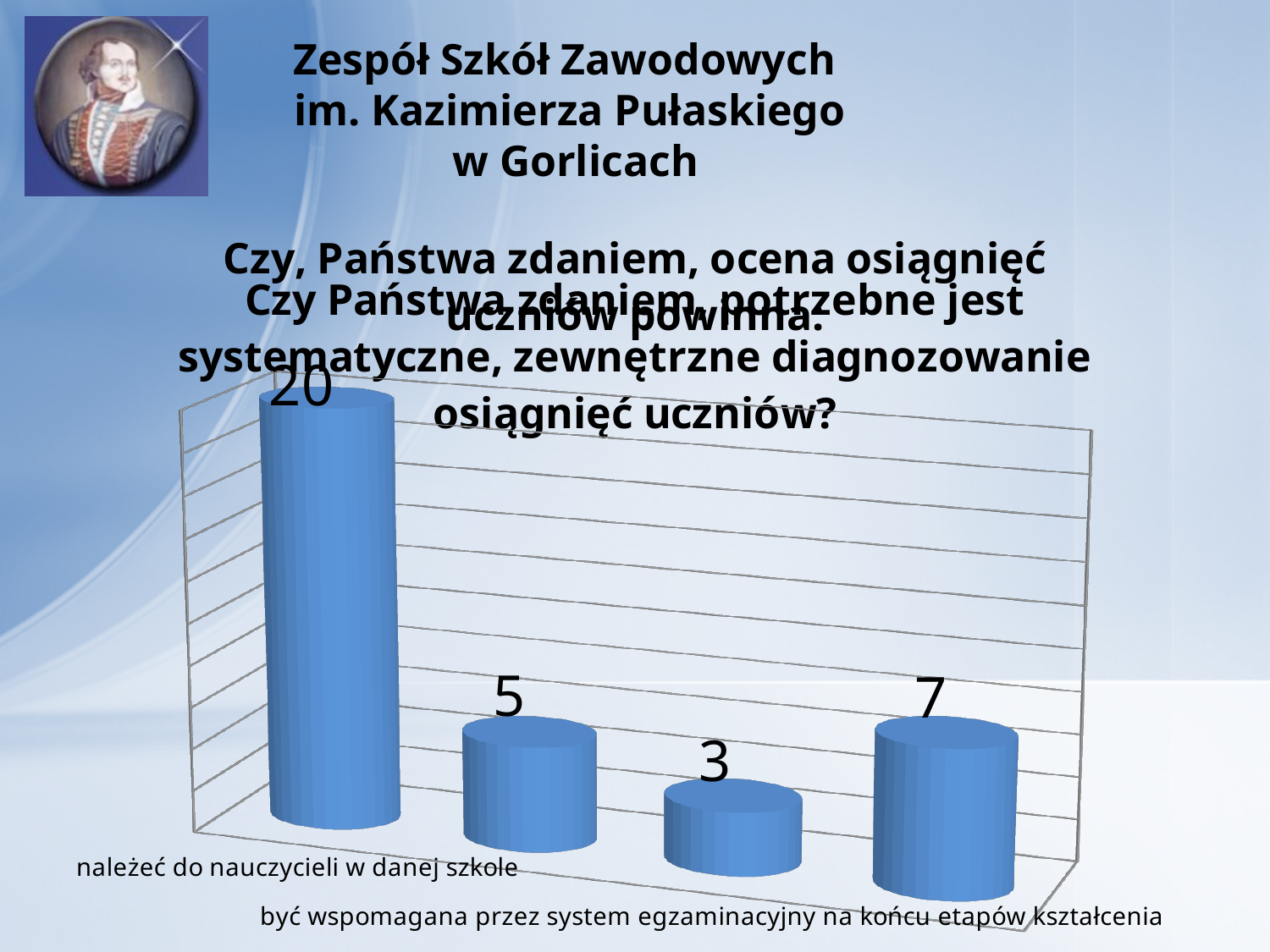
What is the difference between the leftmost bar's value and the rightmost bar's value? 13 What colour are the bars in the chart? blue What is the difference between the rightmost bar's value and the second bar's value? 2 What kind of chart is shown on the slide? bar chart What is the highest value shown in the chart? 20 Which is larger, the value of the second bar from the left or the value of the rightmost bar? the rightmost bar What is the lowest value shown in the chart? 3 What is the value shown on the second bar from the left? 5 What is the value shown on the third bar from the left? 3 What is the value shown on the rightmost bar of the chart? 7 How many bars are plotted in the chart? 4 What is the value shown on the leftmost bar of the chart? 20